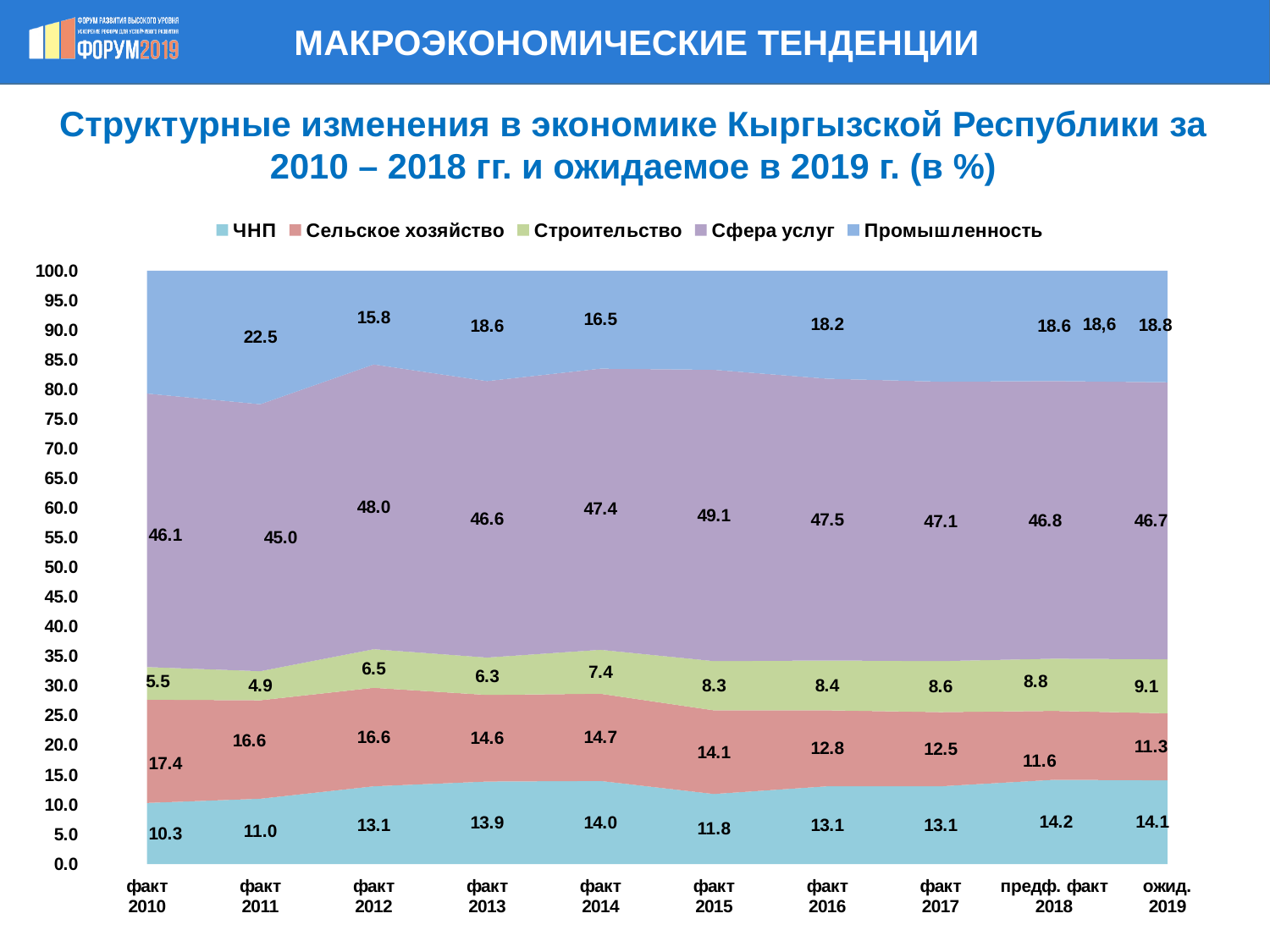
What is the value of Сфера услуг for факт 2015? 49.1 What kind of chart is shown on the slide? Stacked area chart Does the Строительство value rise or fall from факт 2015 to ожид. 2019? Rise What is the difference between the ЧНП values for факт 2010 and ожид. 2019? 3.8 What is the value of Сельское хозяйство for факт 2010? 17.4 In which period is the Сфера услуг value the highest? факт 2015 How many time periods are shown along the x axis? 10 What is the value of Строительство for ожид. 2019? 9.1 What is the value of Промышленность for факт 2011? 22.5 Which is larger: the Строительство value for факт 2011 or for факт 2014? факт 2014 How many series does the legend list? 5 In which period is the Сельское хозяйство value the lowest? ожид. 2019